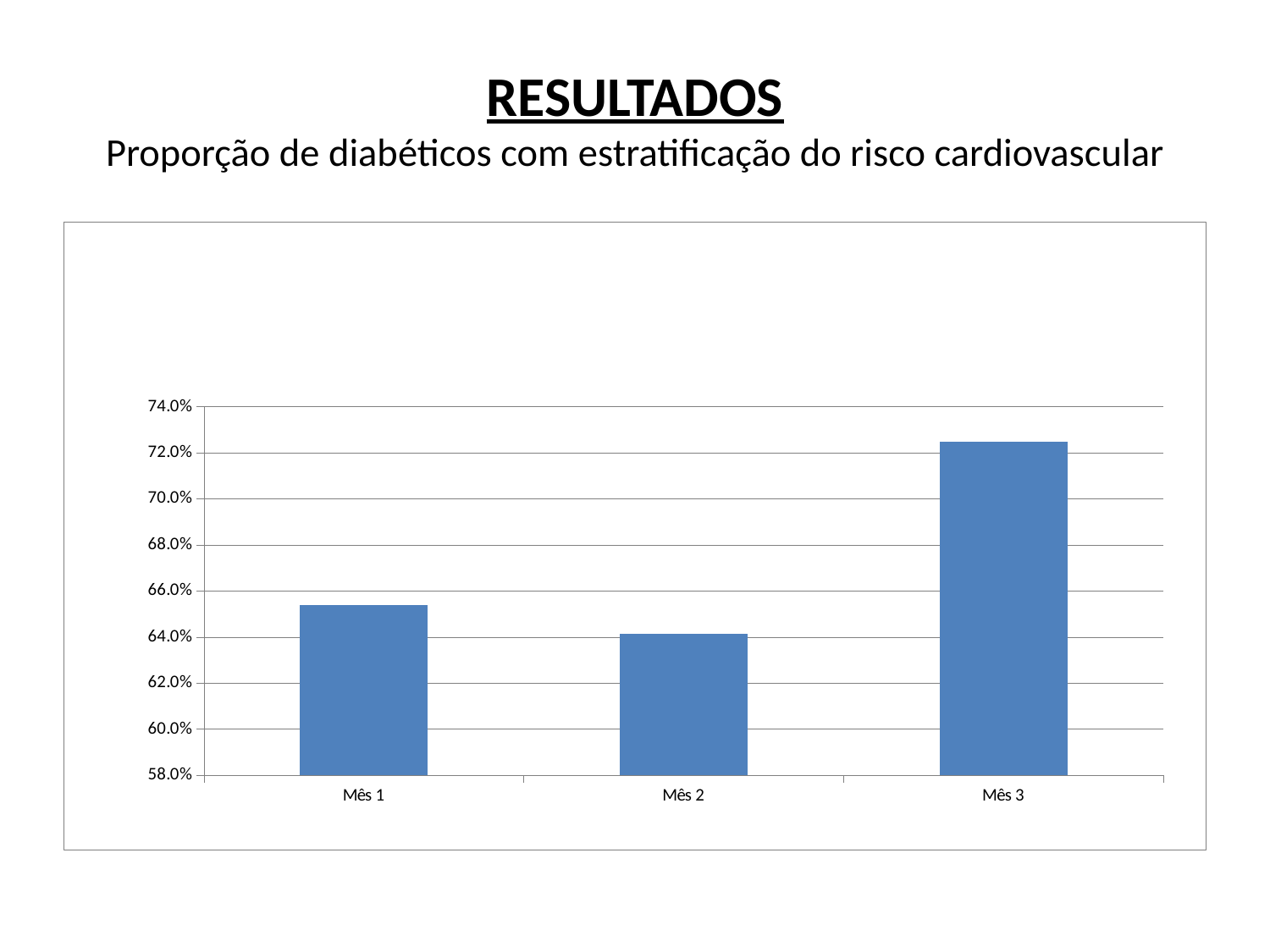
What kind of chart is shown on the slide? bar chart How many categories (months) are plotted on the chart? 3 Which is larger, the value for Mês 3 or the value for Mês 1? Mês 3 What is the subtitle describing the chart on the slide? Proporção de diabéticos com estratificação do risco cardiovascular Is the value for Mês 3 greater or less than 70.0%? greater Which is larger, the value for Mês 1 or the value for Mês 2? Mês 1 Which month has the highest proportion on the chart? Mês 3 Is the value for Mês 3 greater or less than 74.0%? less Is the value for Mês 1 greater or less than 64.0%? greater Which month has the lowest proportion on the chart? Mês 2 Does the value rise or fall from Mês 2 to Mês 3? rise